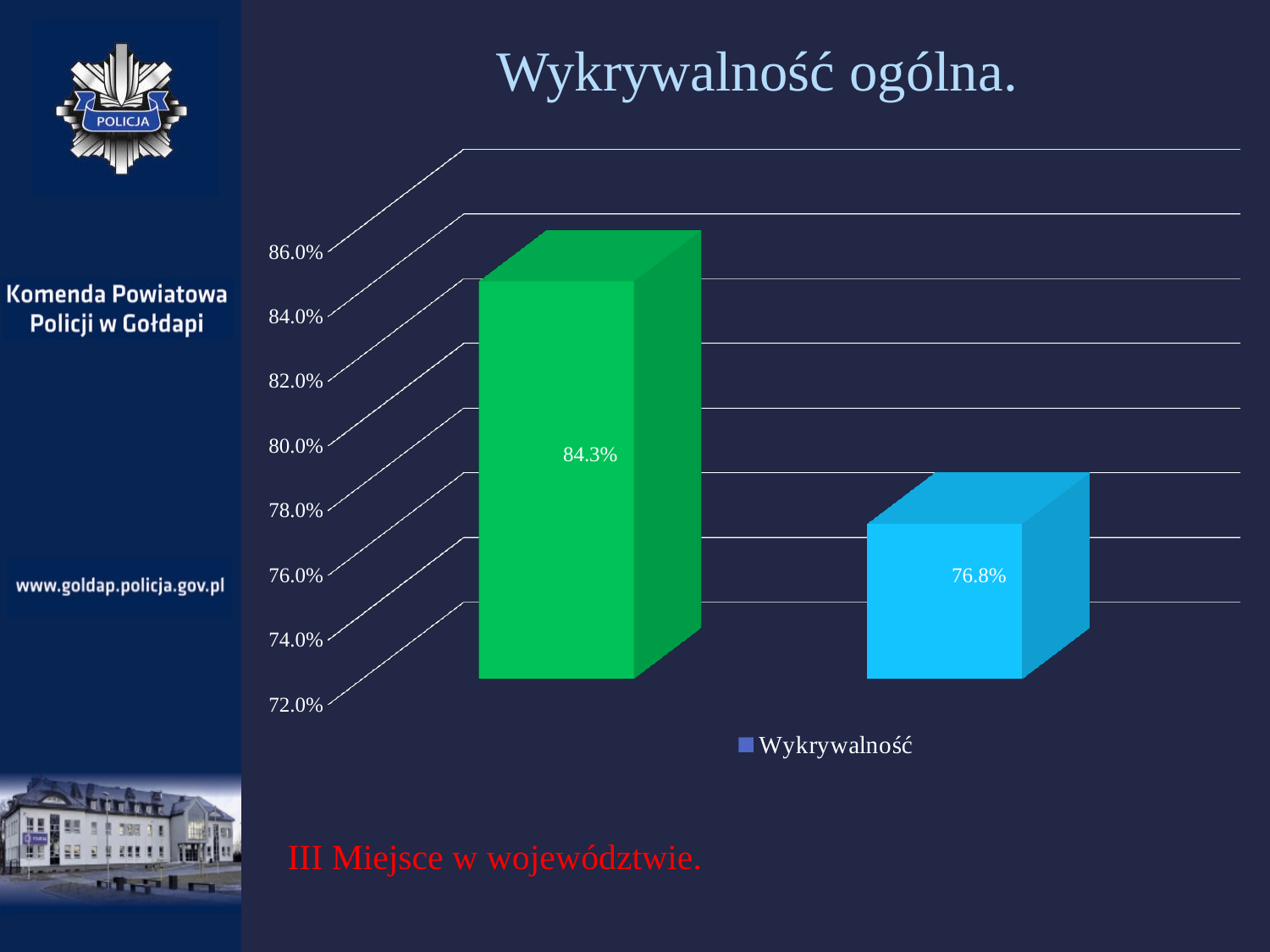
What is the value shown on the blue (right) bar in the chart? 76.8% What is the highest value plotted in the chart? 84.3% Is the value of the right (blue) bar greater or less than 78.0%? less What is the lowest value plotted in the chart? 76.8% Which bar has the higher value, the left (green) bar or the right (blue) bar? the left (green) bar How many series does the legend list? 1 What is the value shown on the green (left) bar in the chart? 84.3% Is the value of the left (green) bar greater or less than 82.0%? greater What kind of chart is shown on the slide? bar chart How many bars are plotted in the chart? 2 What is the difference between the left bar's value and the right bar's value? 7.5 percentage points What is the title of the chart? Wykrywalność ogólna.